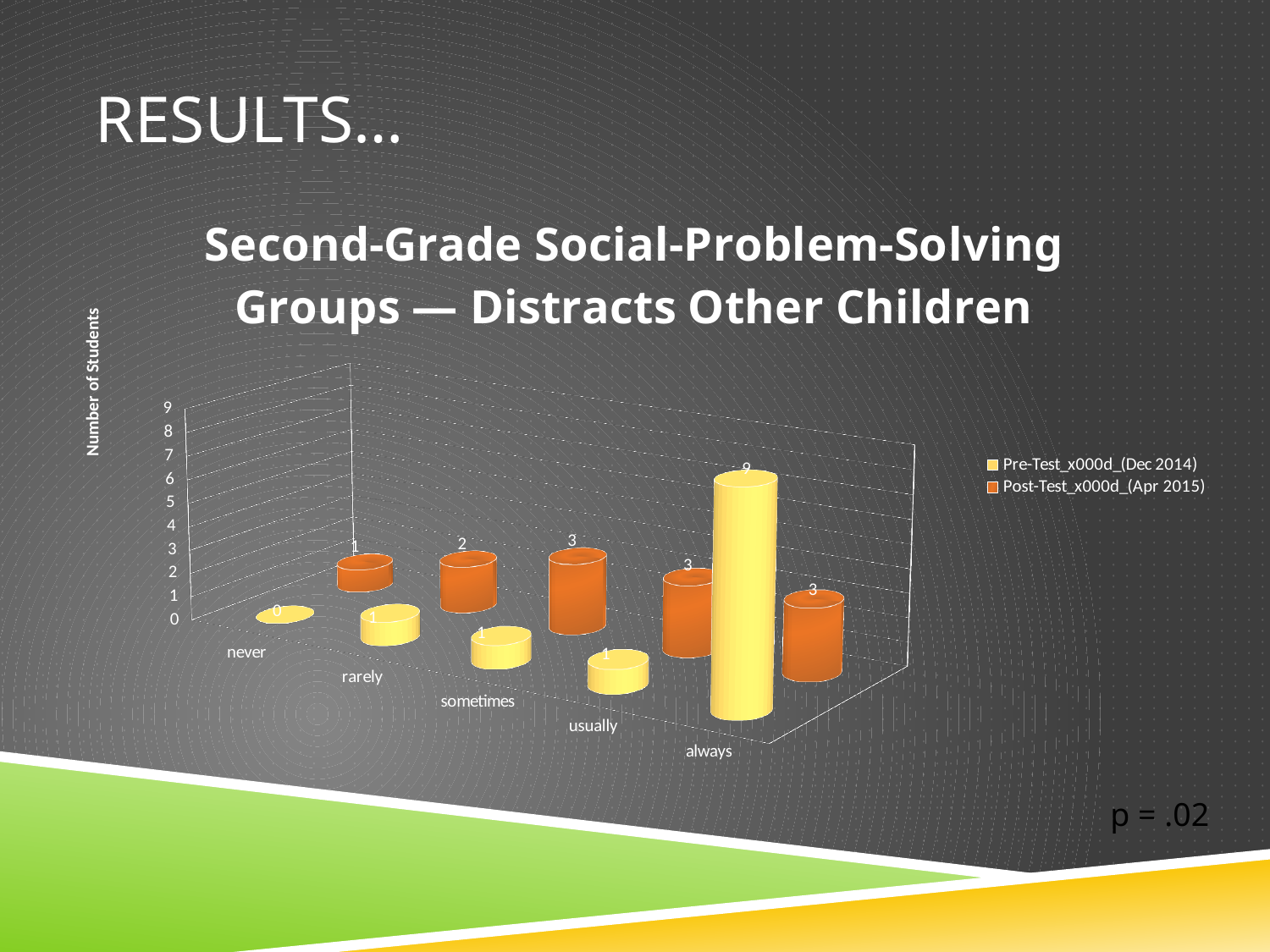
What is the Pre-Test value for 'never'? 0 Which category has the highest Pre-Test value? always What type of chart is shown on the slide? bar chart What is the label of the vertical axis? Number of Students What is the Post-Test value for 'rarely'? 2 What is the Pre-Test value for 'always'? 9 How many categories are shown on the x axis? 5 For 'usually', which is larger: the Pre-Test value or the Post-Test value? Post-Test What is the Post-Test value for 'sometimes'? 3 What is the difference between the Pre-Test and Post-Test values for 'always'? 6 How many series does the legend list? 2 Which category has the lowest Post-Test value? never